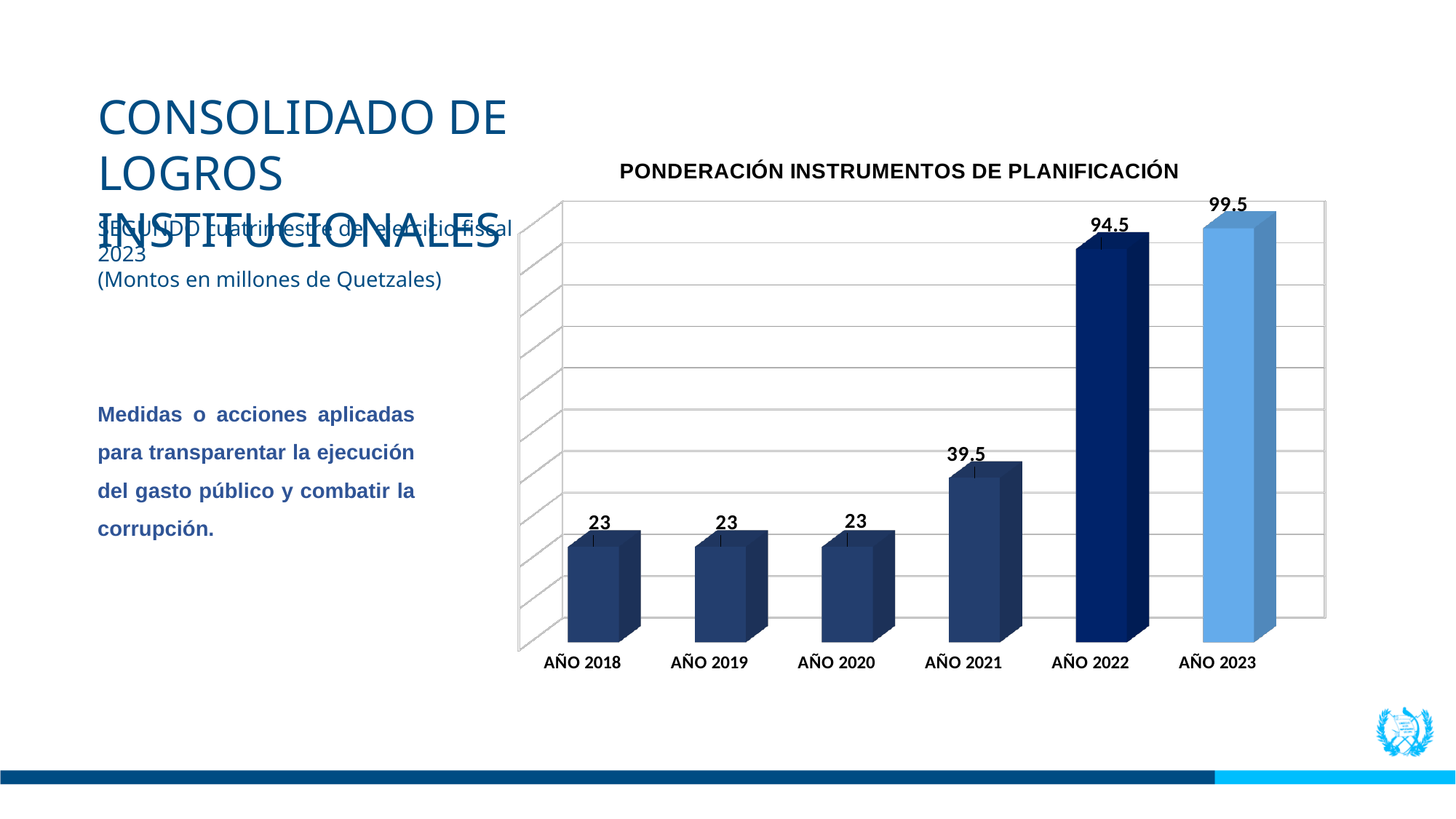
What is the difference between the values for AÑO 2023 and AÑO 2022? 5 What is the value for AÑO 2018? 23 How many years are shown on the x axis? 6 Which is larger, the value for AÑO 2021 or the value for AÑO 2022? AÑO 2022 What is the difference between the values for AÑO 2021 and AÑO 2020? 16.5 What is the value for AÑO 2021? 39.5 What is the title of the chart? PONDERACIÓN INSTRUMENTOS DE PLANIFICACIÓN How many years share the value 23? 3 What is the value for AÑO 2022? 94.5 Do the values rise or fall from AÑO 2020 to AÑO 2023? rise Which year has the highest value? AÑO 2023 What kind of chart is shown? bar chart